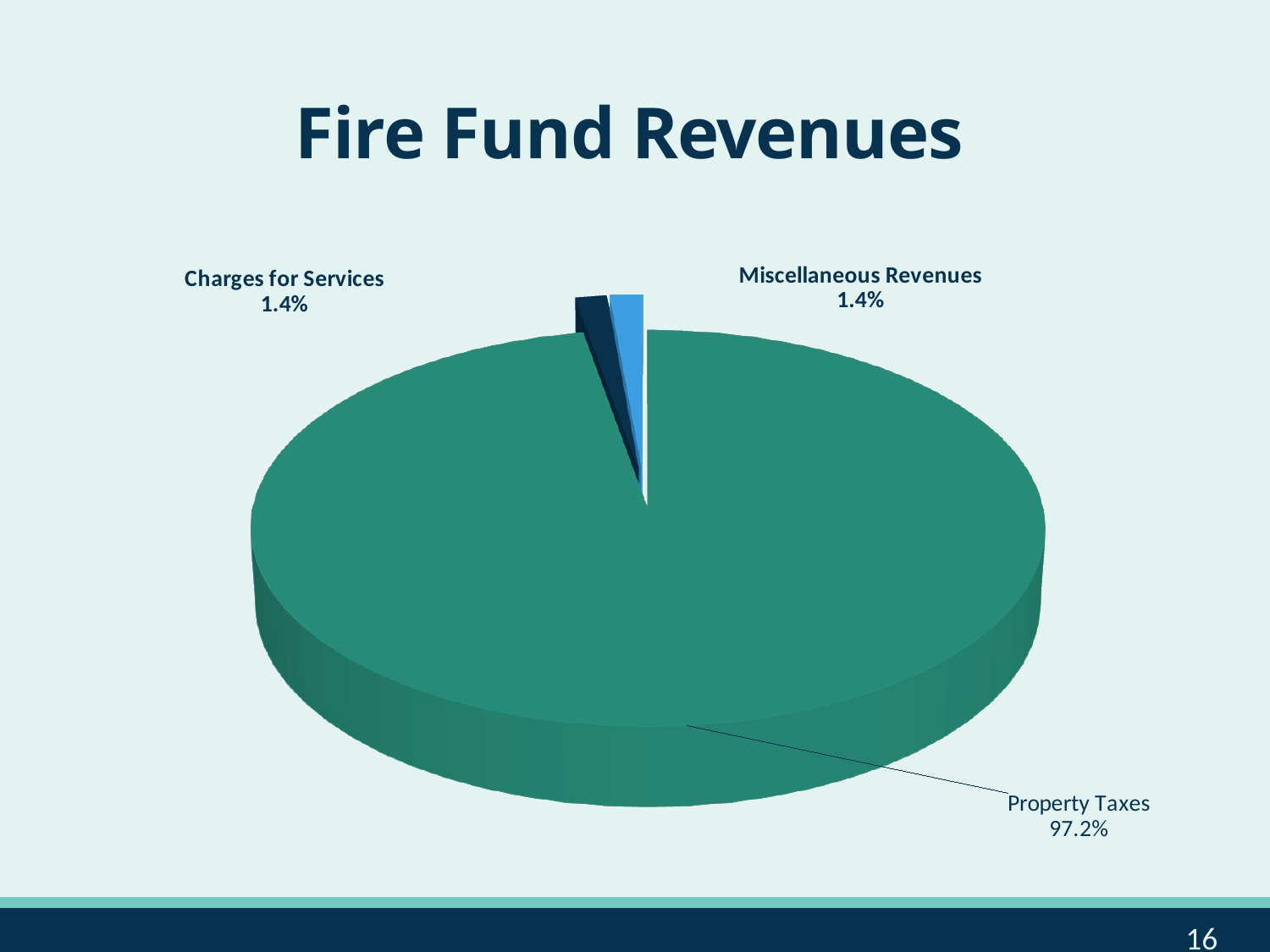
What share of Fire Fund Revenues comes from Property Taxes? 97.2% What colour is the Property Taxes slice in the pie chart? Green What share of Fire Fund Revenues comes from Charges for Services? 1.4% How many categories are shown in the Fire Fund Revenues pie chart? 3 What is the difference in percentage points between the Property Taxes share and the Charges for Services share? 95.8 Which category has the largest share of Fire Fund Revenues? Property Taxes Which is larger, the share for Property Taxes or the share for Miscellaneous Revenues? Property Taxes What share of Fire Fund Revenues comes from Miscellaneous Revenues? 1.4% What kind of chart is shown on the slide? Pie chart What is the title of the chart on the slide? Fire Fund Revenues What is the combined share of Charges for Services and Miscellaneous Revenues? 2.8%